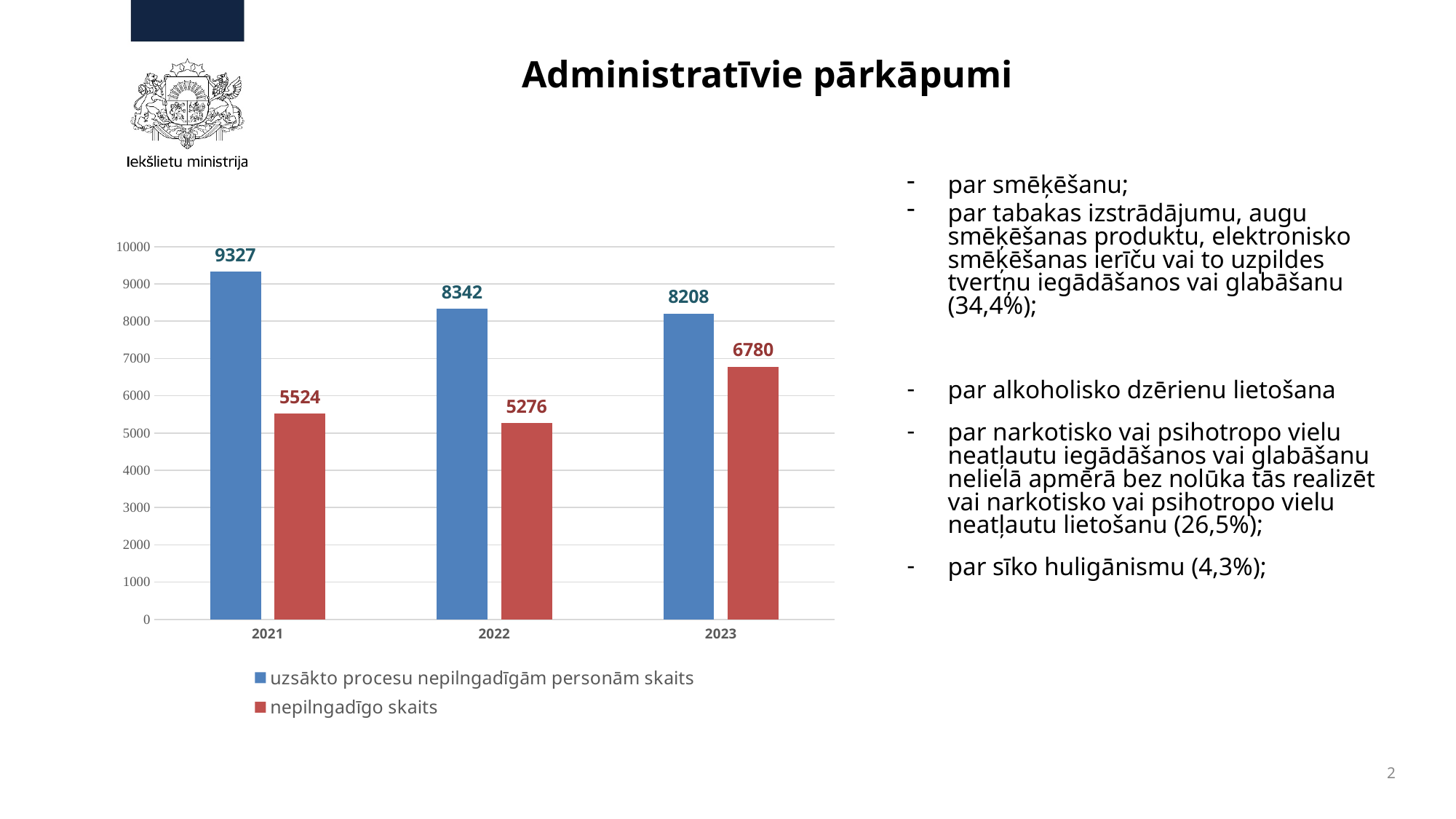
What is the value of 'nepilngadīgo skaits' for 2023? 6780 What is the value of 'uzsākto procesu nepilngadīgām personām skaits' for 2021? 9327 What kind of chart is shown on the slide? bar chart In which year is 'nepilngadīgo skaits' lowest? 2022 Which is larger: 'uzsākto procesu nepilngadīgām personām skaits' in 2022 or in 2023? 2022 Does 'uzsākto procesu nepilngadīgām personām skaits' rise or fall from 2021 to 2023? fall What is the difference between 'nepilngadīgo skaits' in 2023 and in 2022? 1504 What is the difference between 'uzsākto procesu nepilngadīgām personām skaits' and 'nepilngadīgo skaits' in 2021? 3803 In which year is 'uzsākto procesu nepilngadīgām personām skaits' highest? 2021 How many series does the legend list? 2 What is the value of 'nepilngadīgo skaits' for 2022? 5276 How many years are shown on the x axis? 3